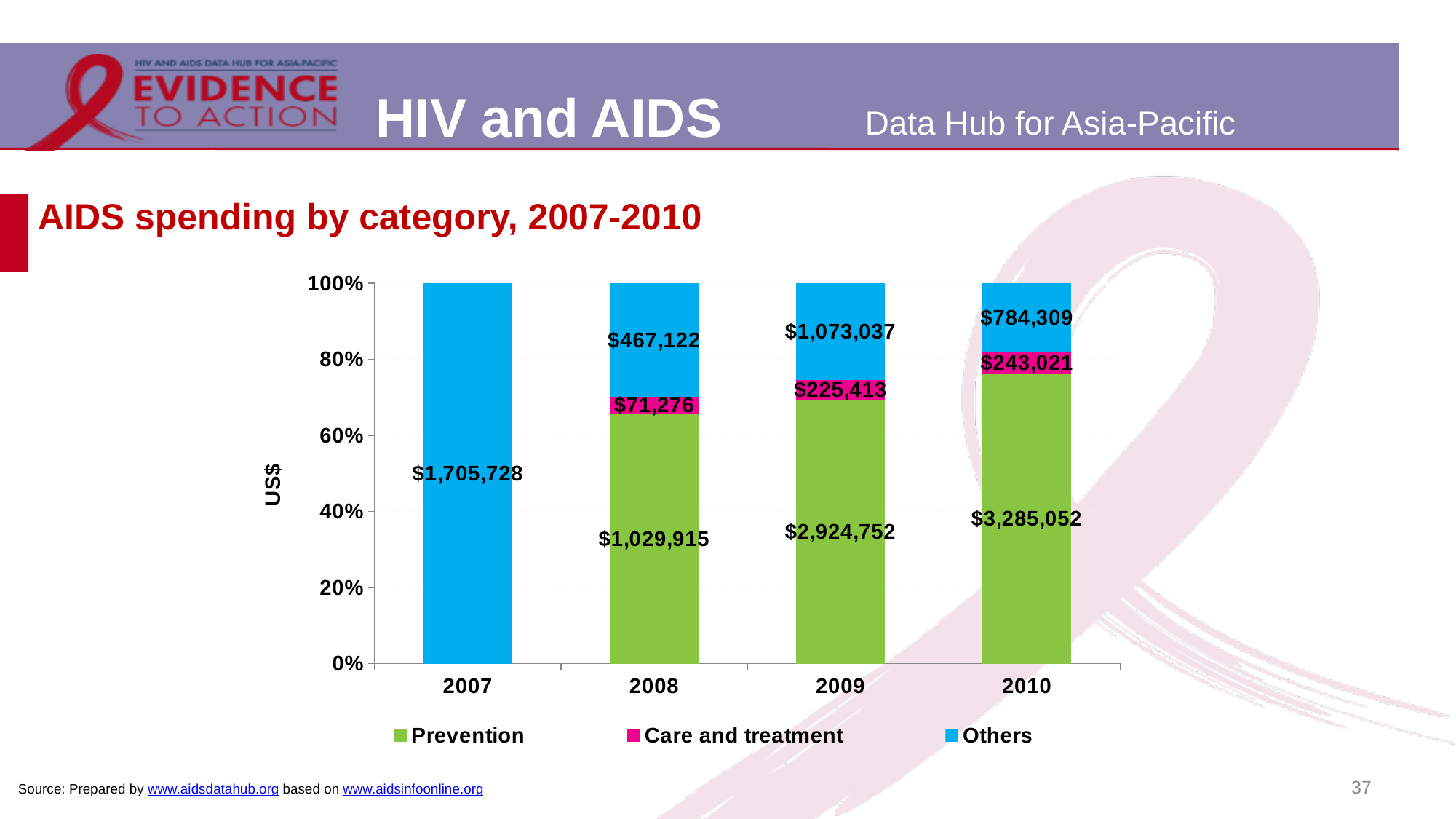
What is the Care and treatment spending value for 2008? $71,276 What is the difference between Prevention spending in 2010 and in 2009? $360,300 What kind of chart is shown on the slide? Stacked bar chart What is the total spending across all three categories in 2008? $1,568,313 In which year is Care and treatment spending lowest? 2008 How many series does the legend list? 3 What is the Prevention spending value for 2009? $2,924,752 How many years are shown on the x axis? 4 What is the Others spending value for 2007? $1,705,728 Which is larger: Others spending in 2009 or Others spending in 2010? Others spending in 2009 In which year is Prevention spending highest? 2010 What is the Others spending value for 2010? $784,309